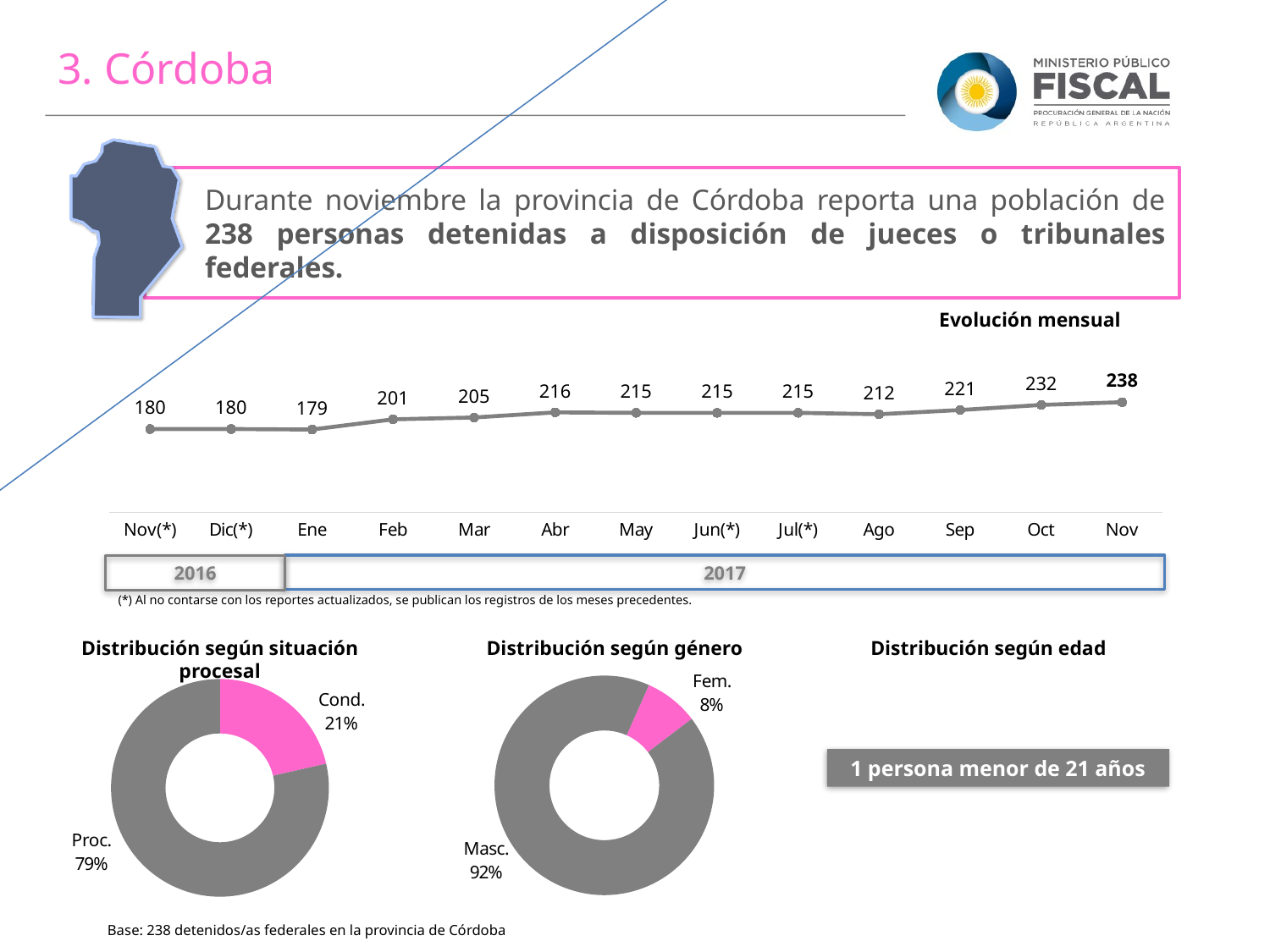
How many data points are plotted in the 'Evolución mensual' line chart? 13 In the 'Evolución mensual' line chart, which month has the lowest value? Ene In the 'Evolución mensual' line chart, do the values generally rise or fall from Nov 2016 to Nov 2017? Rise In the 'Evolución mensual' line chart, what is the difference between the values for Nov 2017 and Oct? 6 In the 'Evolución mensual' line chart, which is larger, the value for Abr or the value for Ago? Abr What kind of chart is 'Evolución mensual'? Line chart In the 'Evolución mensual' line chart, which month has the highest value? Nov (2017) In the 'Distribución según género' chart, what share is Masc.? 92% What kind of chart is 'Distribución según género'? Doughnut chart In the 'Distribución según situación procesal' chart, what share is Cond.? 21% In the 'Evolución mensual' line chart, what is the value for Nov 2017? 238 In the 'Evolución mensual' line chart, what is the value for Feb? 201